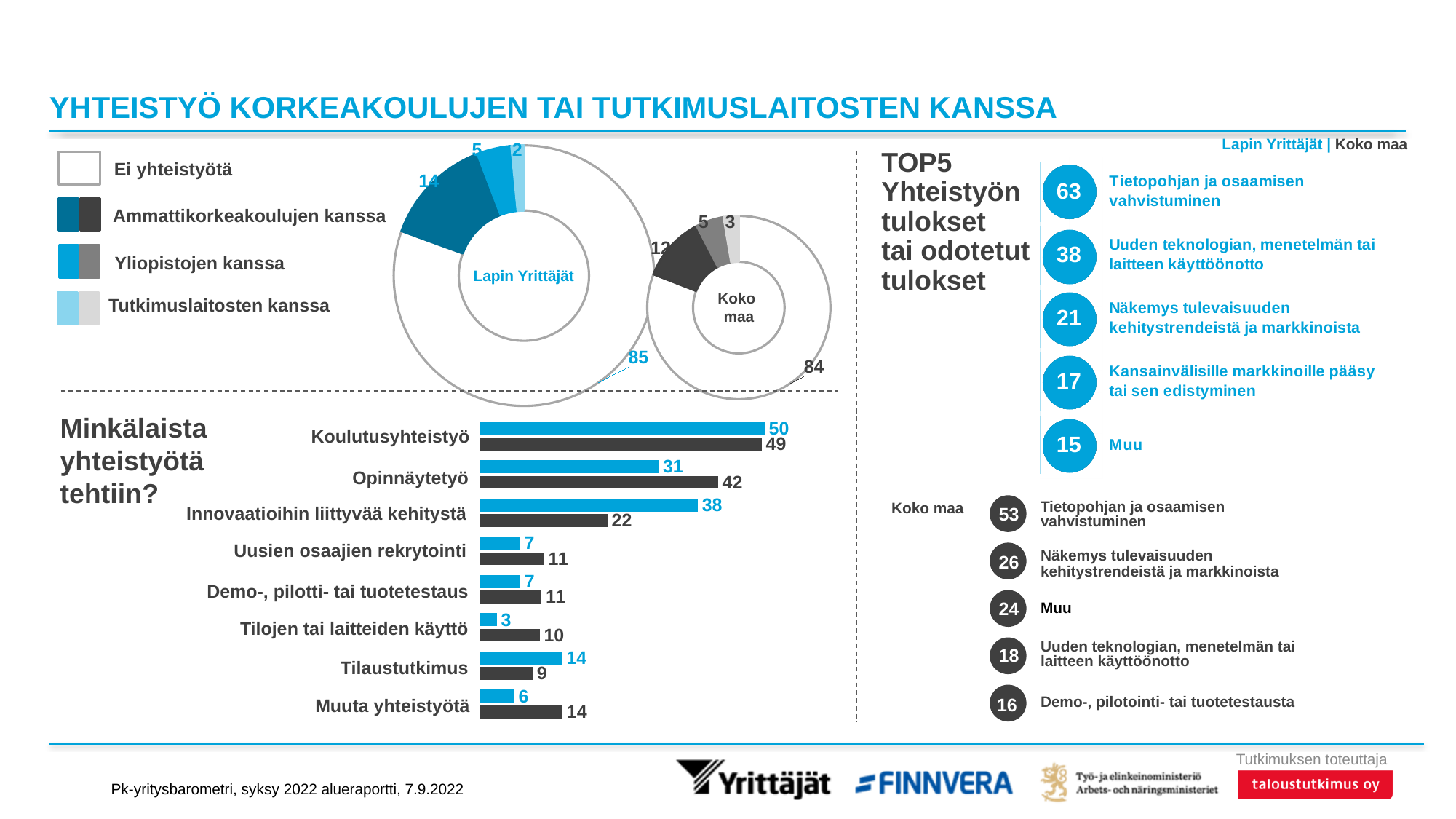
In the bar chart 'Minkälaista yhteistyötä tehtiin?', what is the difference between the Lapin Yrittäjät and Koko maa values for Innovaatioihin liittyvää kehitystä? 16 What type of chart is 'Minkälaista yhteistyötä tehtiin?'? bar chart How many categories does the legend of the donut charts list? 4 In the bar chart 'Minkälaista yhteistyötä tehtiin?', what is the Koko maa value for Opinnäytetyö? 42 In the Koko maa donut chart, what is the value for Ammattikorkeakoulujen kanssa? 12 In the bar chart 'Minkälaista yhteistyötä tehtiin?', which category has the lowest Lapin Yrittäjät value? Tilojen tai laitteiden käyttö How many categories does the bar chart 'Minkälaista yhteistyötä tehtiin?' show? 8 In the bar chart 'Minkälaista yhteistyötä tehtiin?', is the Lapin Yrittäjät or the Koko maa value larger for Tilaustutkimus? Lapin Yrittäjät In the bar chart 'Minkälaista yhteistyötä tehtiin?', what is the Lapin Yrittäjät value for Koulutusyhteistyö? 50 In the Lapin Yrittäjät donut chart, what is the value for Ei yhteistyötä? 85 In the Lapin Yrittäjät donut chart, what is the difference between Ammattikorkeakoulujen kanssa and Yliopistojen kanssa? 9 In the bar chart 'Minkälaista yhteistyötä tehtiin?', which category has the highest Koko maa value? Koulutusyhteistyö